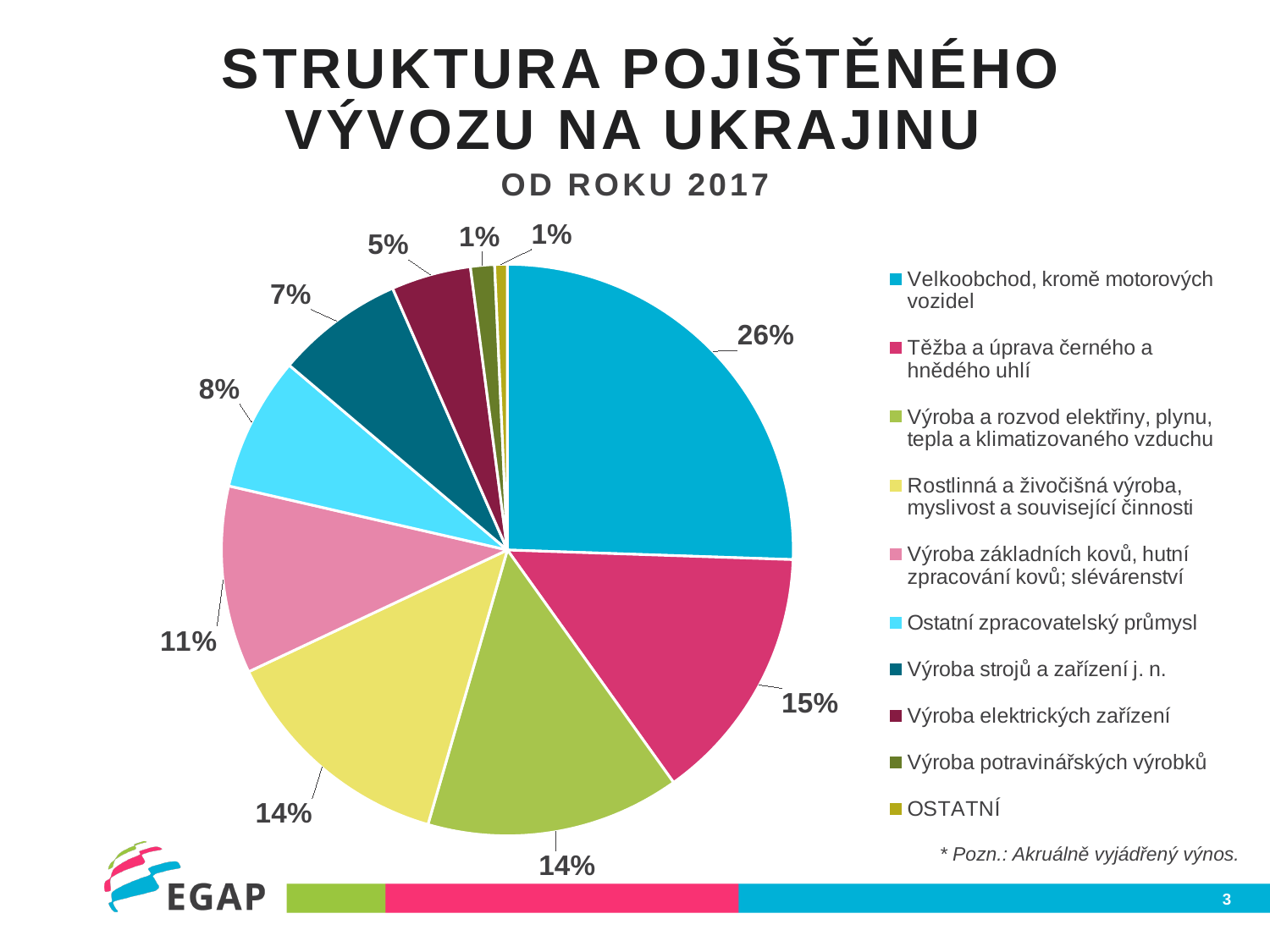
How many slices does the pie chart have? 10 What is the value for "Výroba strojů a zařízení j. n."? 7% What share of the pie does "Velkoobchod, kromě motorových vozidel" represent? 26% Which category has the largest share of the pie? Velkoobchod, kromě motorových vozidel What is the value for "Výroba elektrických zařízení"? 5% How many entries does the legend list? 10 Which is larger: the share of "Ostatní zpracovatelský průmysl" or "Výroba strojů a zařízení j. n."? Ostatní zpracovatelský průmysl What is the title of the chart on the slide? STRUKTURA POJIŠTĚNÉHO VÝVOZU NA UKRAJINU OD ROKU 2017 What type of chart is shown on the slide? pie chart What is the value for "Těžba a úprava černého a hnědého uhlí"? 15% What is the value for "Výroba základních kovů, hutní zpracování kovů; slévárenství"? 11% What is the difference between the share of "Velkoobchod, kromě motorových vozidel" and "Těžba a úprava černého a hnědého uhlí"? 11%